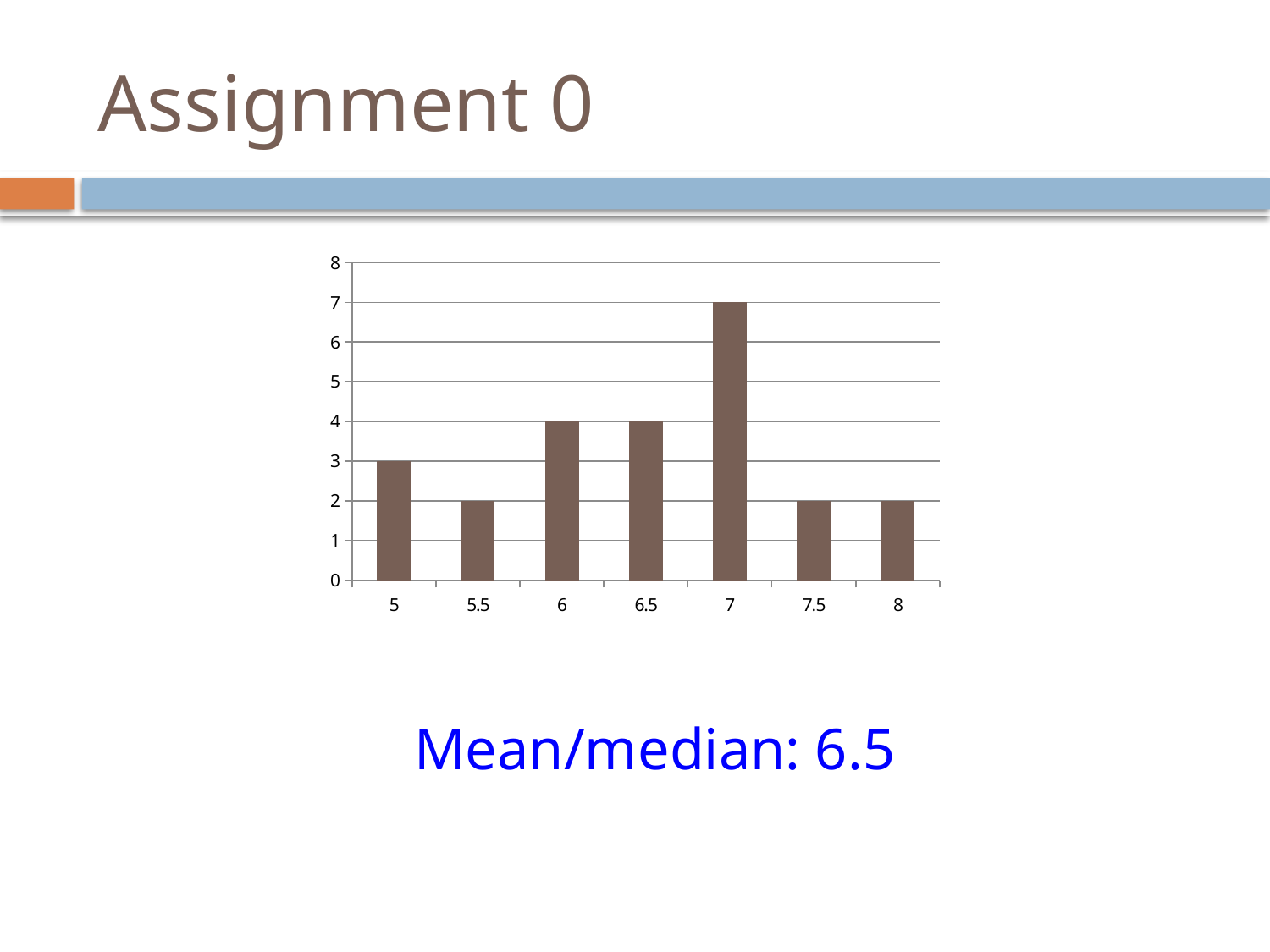
What is the value of the bar for category 6.5? 4 What mean/median value is stated below the chart? 6.5 What is the value of the bar for category 8? 2 How many bars are plotted in the chart? 7 What is the difference between the values for category 7 and category 5? 4 Is the value for category 5.5 greater or less than 3? less Is the value for category 7 greater or less than 6? greater What is the value of the bar for category 7? 7 What type of chart is shown on the slide? bar chart Which is larger, the value for category 6 or the value for category 7.5? 6 Which category has the highest bar? 7 What is the value of the bar for category 5? 3